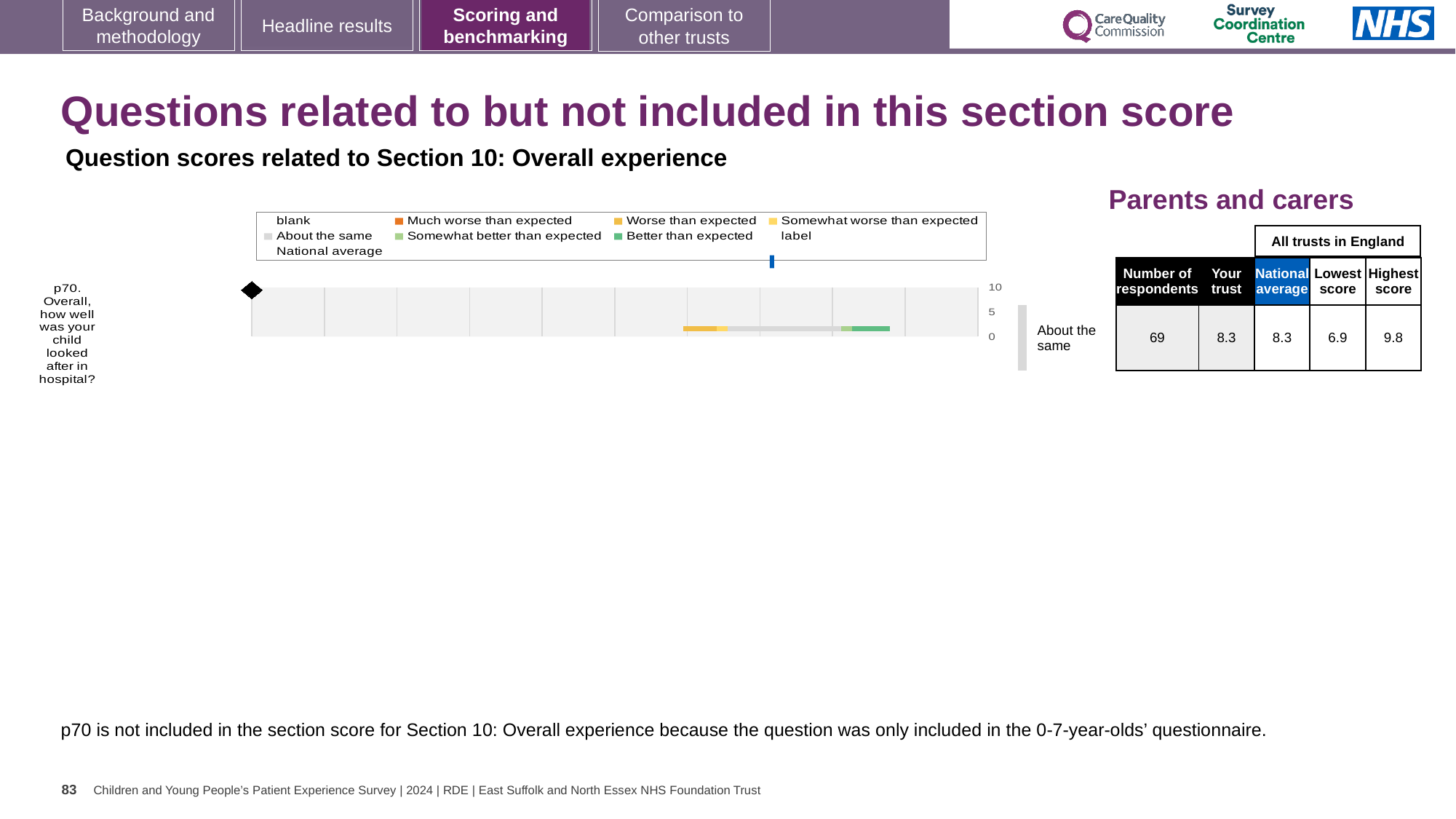
What is the national average score for p70? 8.3 How many questions are plotted on the chart? 1 What is the difference between the highest score and the 'Your trust' score for p70? 1.5 Is the 'Your trust' score for p70 greater or less than 5? greater What kind of chart is used to show the p70 question score? bar chart What benchmark category label is shown next to the chart for p70? About the same What is the lowest score among all trusts in England for p70? 6.9 Is the 'Your trust' score for p70 higher than, lower than, or the same as the national average? the same How many respondents answered p70? 69 What is the difference between the highest score and the lowest score for p70? 2.9 What is the 'Your trust' score for p70 (Overall, how well was your child looked after in hospital?)? 8.3 What is the highest score among all trusts in England for p70? 9.8